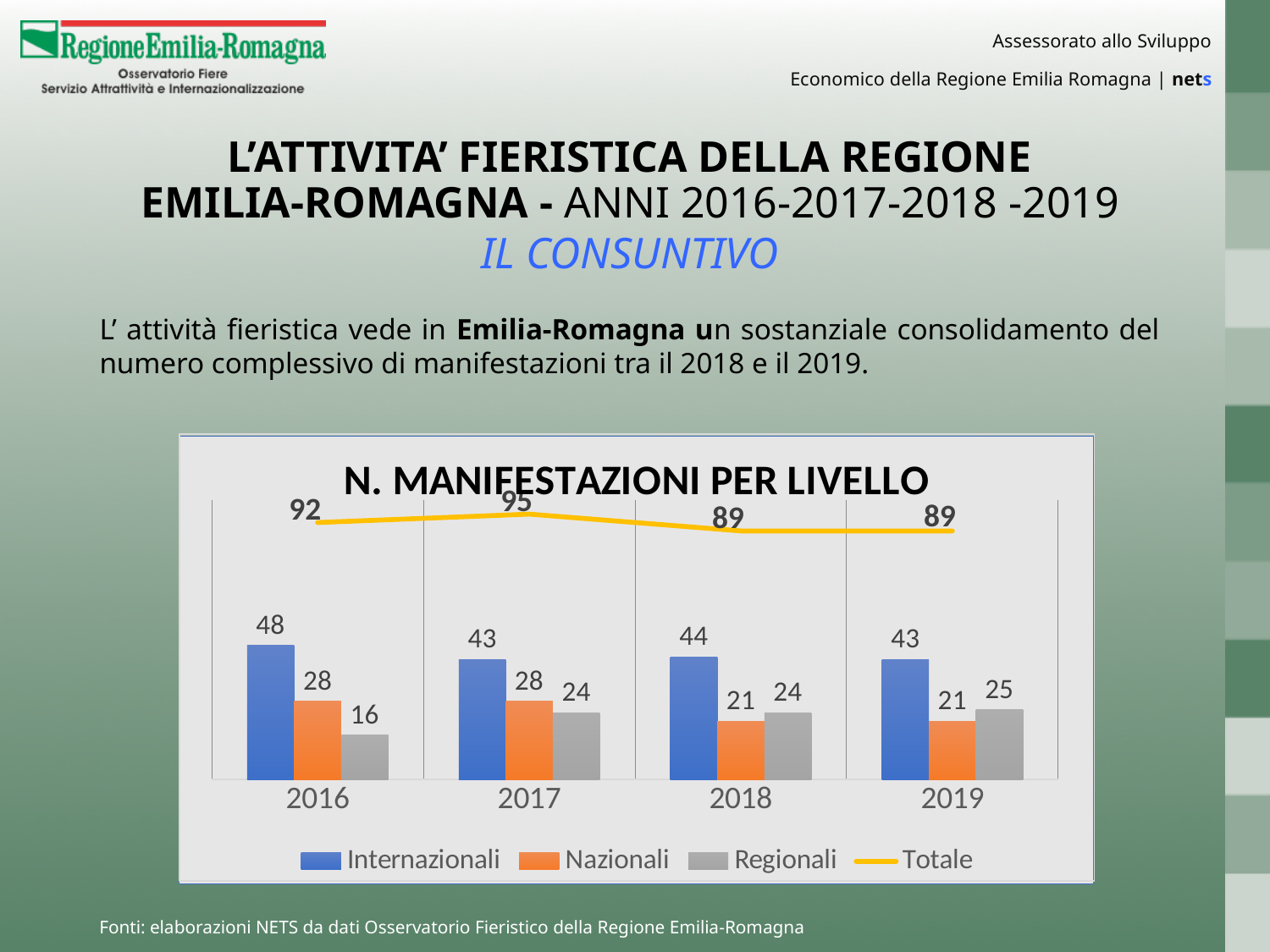
How many series does the legend list? 4 In which year is the Regionali value lowest? 2016 What is the difference between the Internazionali values for 2016 and 2017? 5 In which year is the Totale line highest? 2017 What is the value for Regionali in 2019? 25 What kind of chart is this? Combined bar and line chart How many years are shown on the x axis? 4 What is the value for Nazionali in 2018? 21 Which is larger in 2019: Nazionali or Regionali? Regionali What is the value for Internazionali in 2016? 48 What is the title of the chart? N. MANIFESTAZIONI PER LIVELLO What is the Totale value for 2017? 95